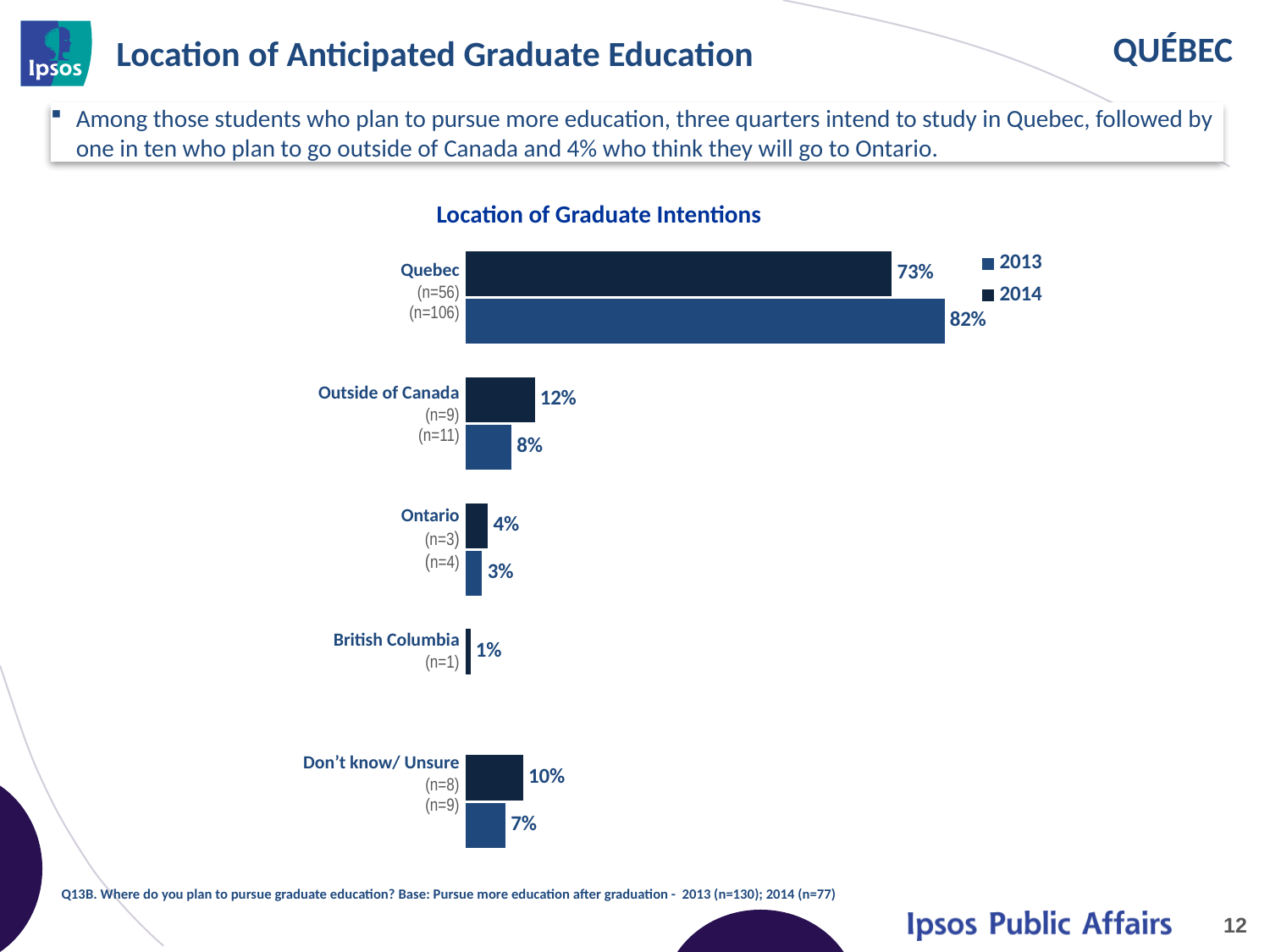
What is the value of the upper (top) bar for Quebec? 73% What is the difference between the two Quebec bars (82% and 73%)? 9 percentage points Which is larger: the upper bar for Don't know/ Unsure or the upper bar for Ontario? Don't know/ Unsure What is the value shown for British Columbia? 1% What type of chart is shown on the slide? bar chart What is the title of the chart? Location of Graduate Intentions Which location has the highest values on the chart? Quebec Which location has the lowest value on the chart? British Columbia How many location categories are shown on the chart? 5 What is the value of the upper bar for Outside of Canada? 12% What is the value of the lower bar for Quebec? 82% How many series does the chart legend list? 2